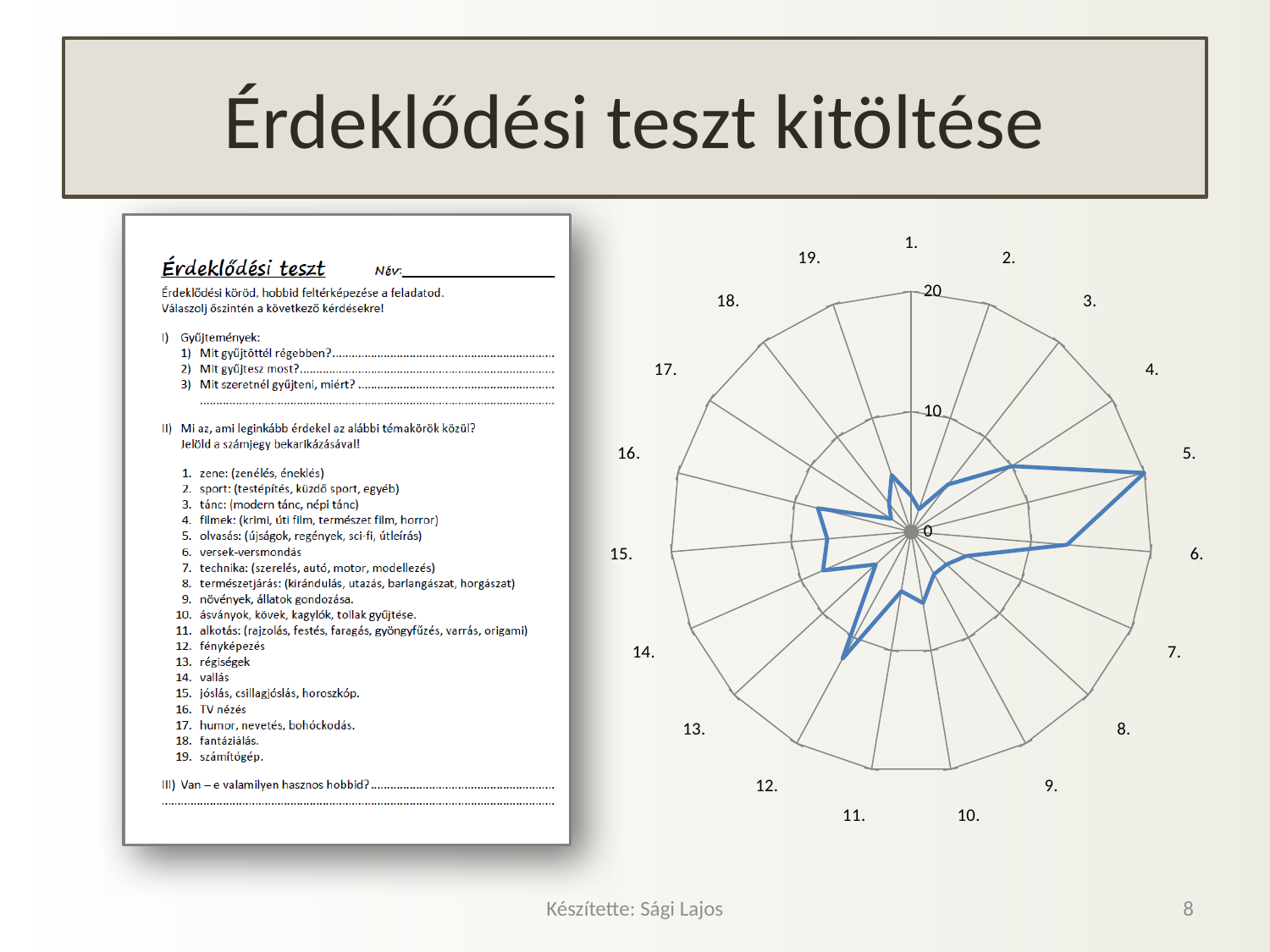
What is the maximum value shown on the radar chart's axis scale? 20 How many categories (numbered axes) does the radar chart have? 19 Is the value for category 3. greater or less than 10? less Which category has the highest value in the radar chart? 5. What is the title of the slide containing the radar chart? Érdeklődési teszt kitöltése Is the value for category 10. greater or less than 10? less Is the value for category 1. greater or less than 10? less Which has the larger value, category 5. or category 16.? 5. What kind of chart is shown on the right side of the slide? radar chart Which has the larger value, category 5. or category 1.? 5.